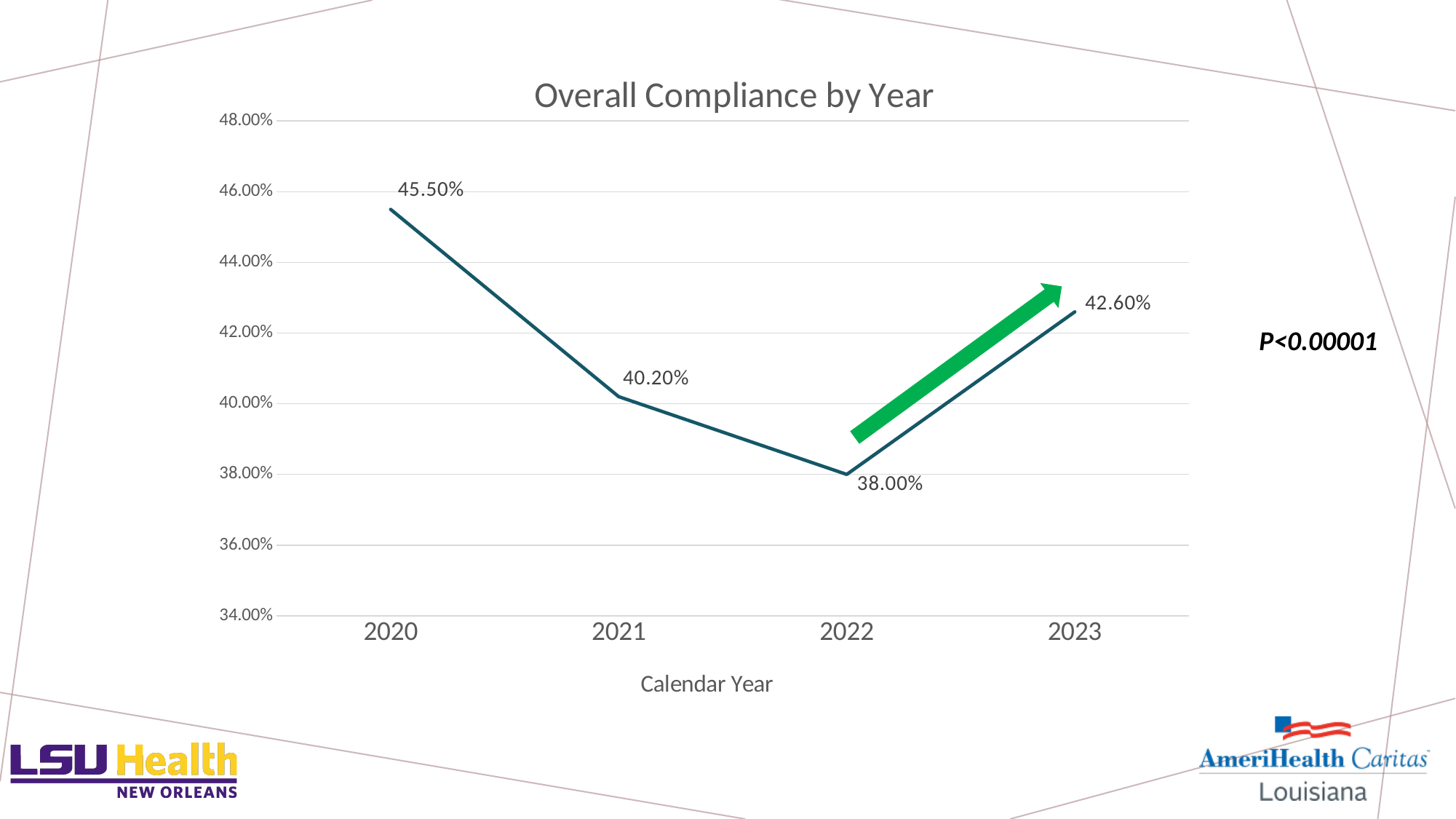
What is the difference in overall compliance between 2023 and 2022? 4.60% Which year has the highest overall compliance? 2020 What is the overall compliance value for 2020? 45.50% Which year has the lowest overall compliance? 2022 What is the title of the chart? Overall Compliance by Year What is the overall compliance value for 2021? 40.20% What is the overall compliance value for 2022? 38.00% Which year has a higher overall compliance, 2021 or 2023? 2023 What kind of chart is shown on the slide? Line chart How many years are plotted on the chart? 4 What is the difference in overall compliance between 2020 and 2021? 5.30% What is the overall compliance value for 2023? 42.60%